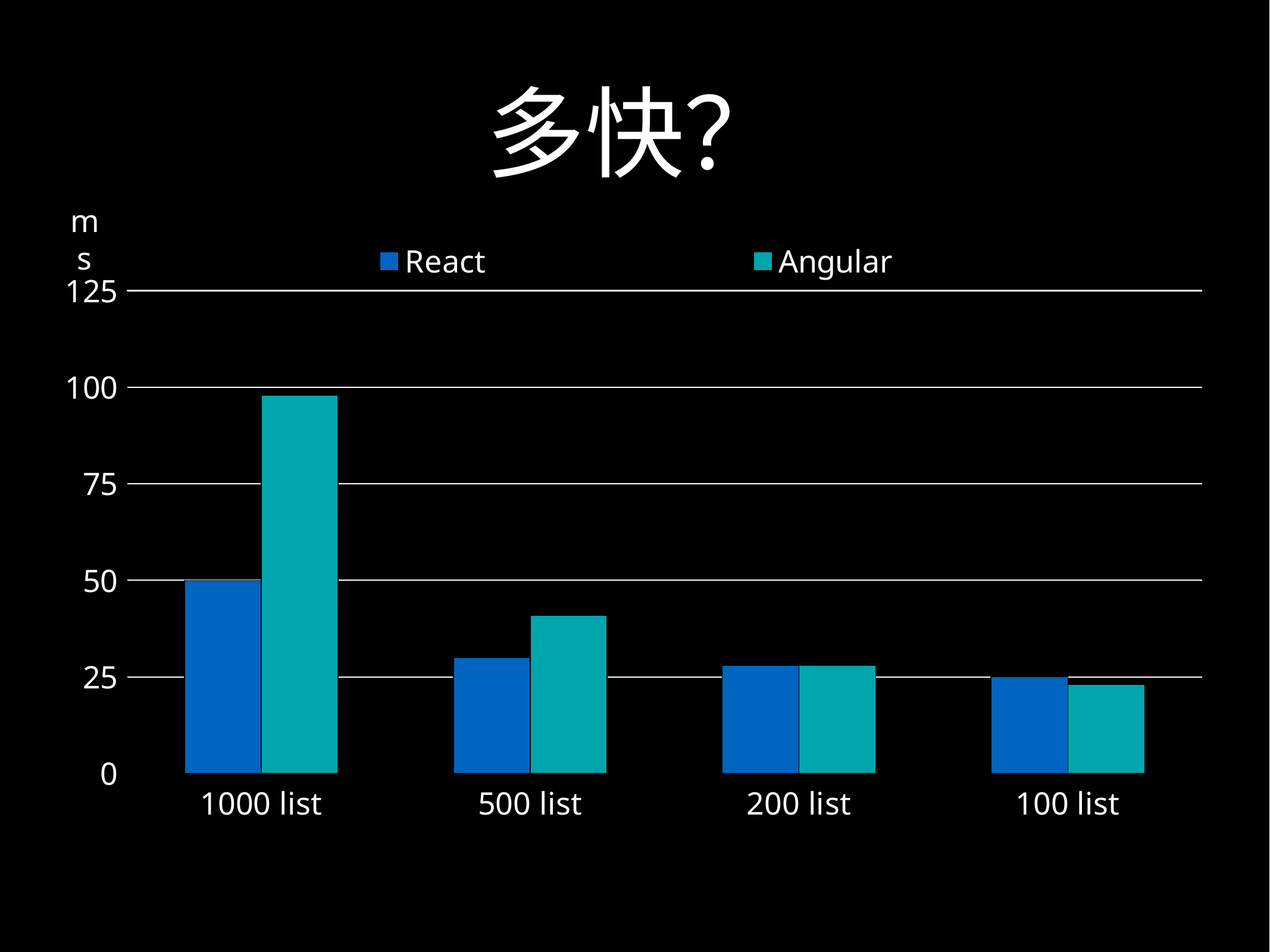
Do the React values rise or fall from 1000 list to 100 list? fall Which category has the highest Angular value? 1000 list Is the Angular value for 100 list greater or less than 25? less How many categories are shown on the x axis? 4 For 1000 list, which is larger, React or Angular? Angular Which category has the lowest Angular value? 100 list Is the Angular value for 1000 list greater or less than 75? greater What is the React value for 100 list? 25 Is the Angular value for 500 list greater or less than 50? less How many series does the legend list? 2 What kind of chart is shown on the slide? bar chart What is the React value for 1000 list? 50